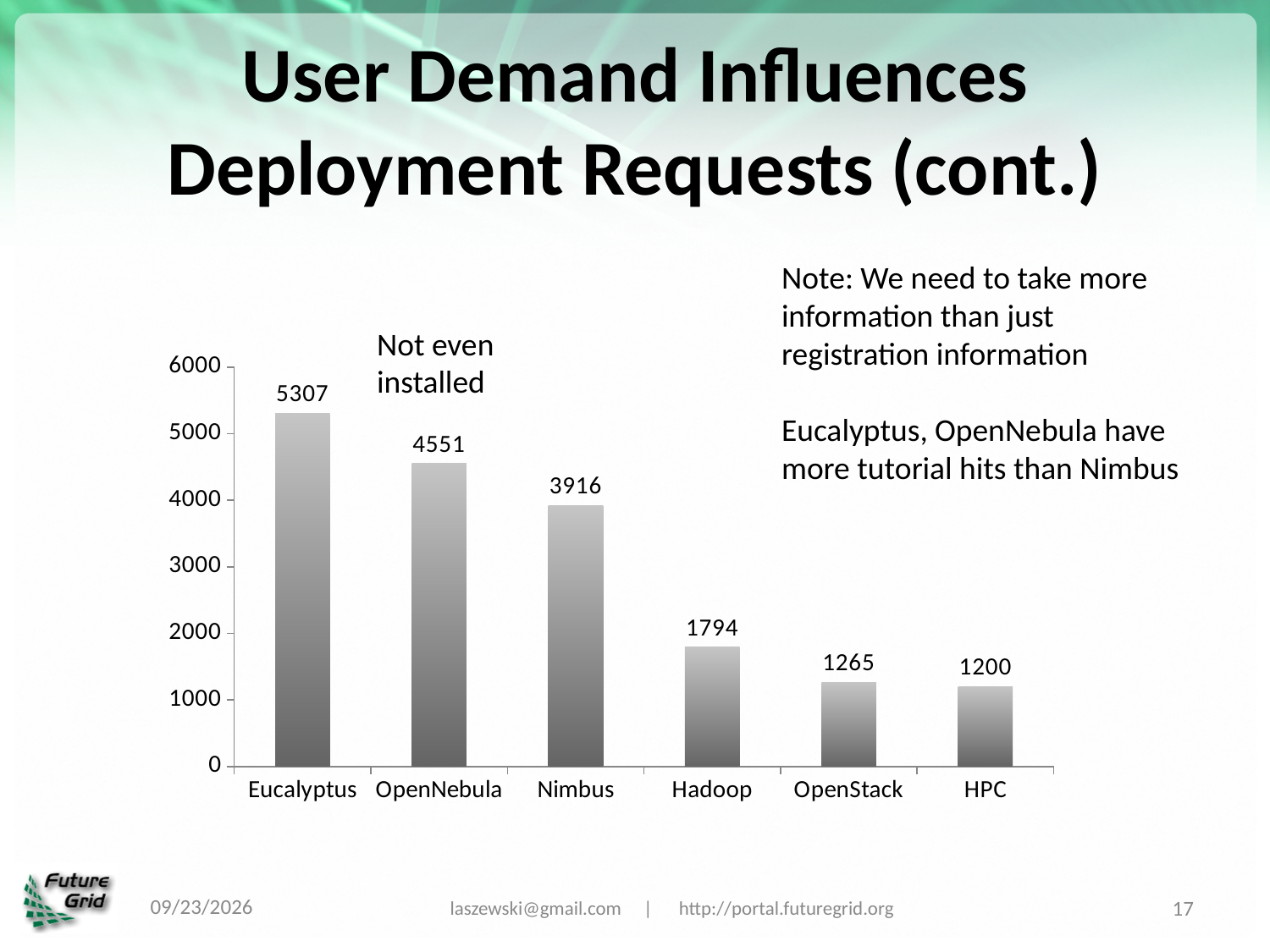
Which is larger, the value for Nimbus or the value for Hadoop? Nimbus What is the difference between the values for Eucalyptus and Nimbus? 1391 What is the difference between the values for OpenStack and HPC? 65 What is the value for Hadoop? 1794 What is the value for Eucalyptus? 5307 What is the value for OpenNebula? 4551 How many categories are shown on the x axis? 6 What is the value for HPC? 1200 Which category has the lowest value? HPC Which category has the highest value? Eucalyptus Do the values rise or fall from left to right along the x axis? fall What kind of chart is shown on the slide? bar chart